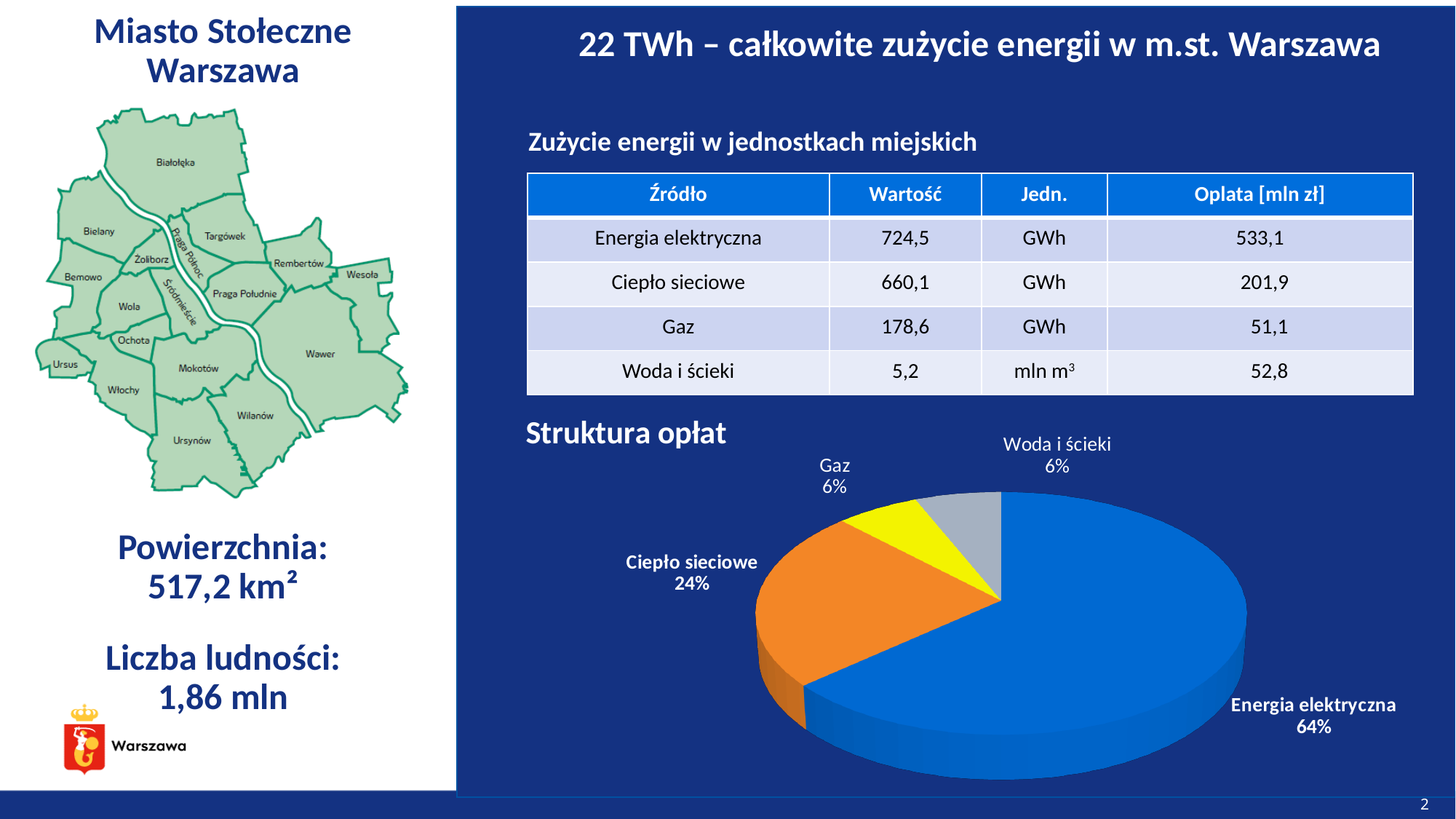
What kind of chart is shown under the heading "Struktura opłat"? pie chart In the "Struktura opłat" pie chart, which slice is larger: Ciepło sieciowe or Gaz? Ciepło sieciowe In the "Struktura opłat" pie chart, what share does Energia elektryczna have? 64% How many slices does the "Struktura opłat" pie chart have? 4 In the "Struktura opłat" pie chart, what share does Ciepło sieciowe have? 24% What is the title of the pie chart on the slide? Struktura opłat Which category has the largest slice in the "Struktura opłat" pie chart? Energia elektryczna In the "Struktura opłat" pie chart, how many percentage points larger is the Energia elektryczna share than the Ciepło sieciowe share? 40 percentage points In the "Struktura opłat" pie chart, what share does Gaz have? 6% What colour is the Ciepło sieciowe slice in the "Struktura opłat" pie chart? orange In the "Struktura opłat" pie chart, is the share for Energia elektryczna greater or less than 50%? greater